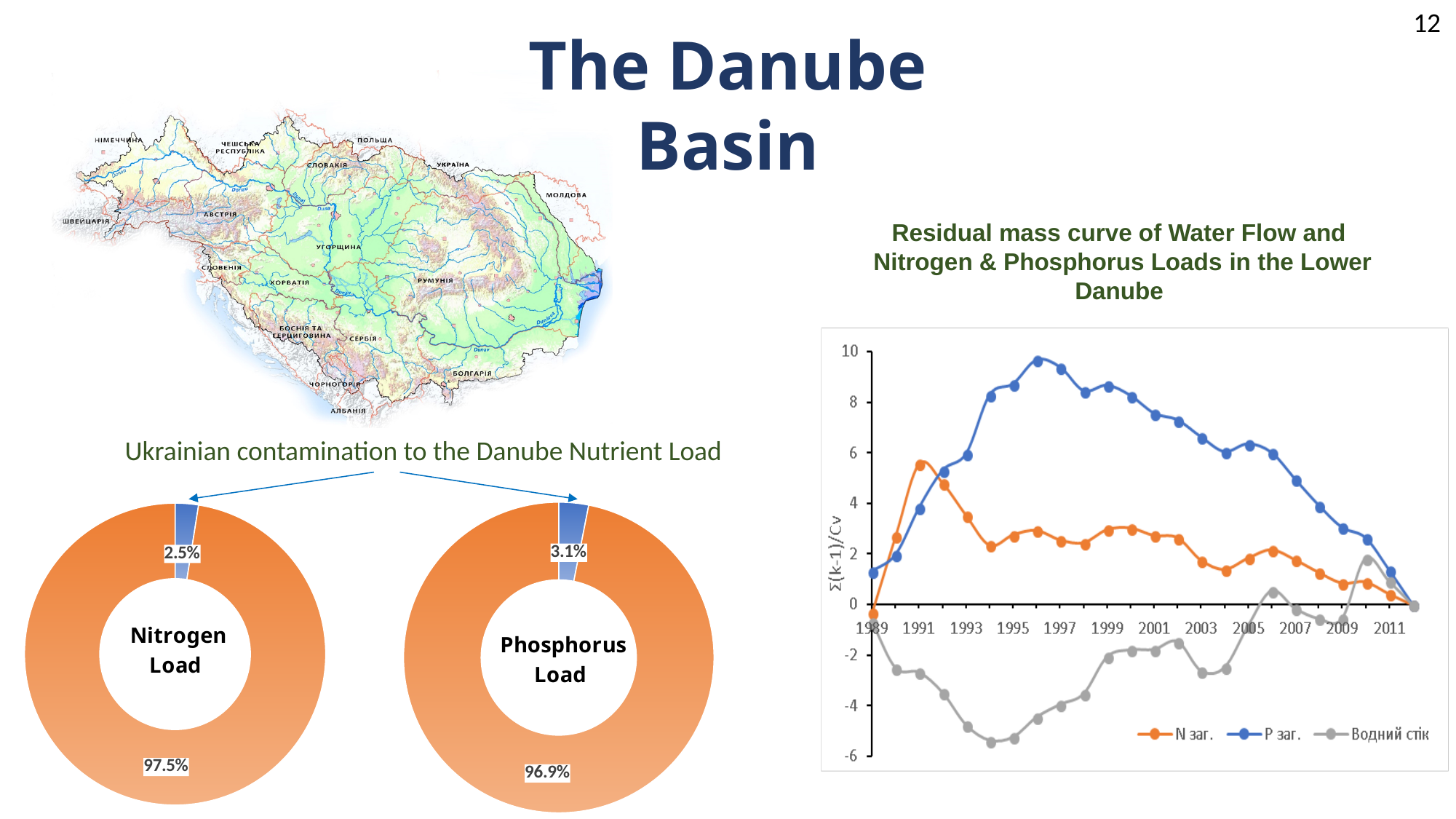
In the 'Residual mass curve' chart, does the P заг. series rise or fall between 1997 and 2011? Fall In the Phosphorus Load donut chart, what share of the load is attributed to Ukrainian contamination? 3.1% In the Phosphorus Load donut chart, what is the value of the large orange slice? 96.9% Which is larger: the Ukrainian share of the Nitrogen Load or the Ukrainian share of the Phosphorus Load? Phosphorus Load What is the difference between the Ukrainian share of the Phosphorus Load (3.1%) and the Ukrainian share of the Nitrogen Load (2.5%)? 0.6% In the 'Residual mass curve' chart, is the lowest value of the Водний стік series (around 1994) greater or less than -4? less In the Nitrogen Load donut chart, what share of the load is attributed to Ukrainian contamination? 2.5% What type of chart is the 'Residual mass curve of Water Flow and Nitrogen & Phosphorus Loads in the Lower Danube'? Line chart How many series does the legend of the 'Residual mass curve' chart list? 3 What type of chart is used to show the Nitrogen Load and Phosphorus Load? Donut (pie) chart In the Nitrogen Load donut chart, what is the value of the large orange slice? 97.5% In the 'Residual mass curve' chart, is the peak value of the P заг. series (around 1996) greater or less than 8? greater